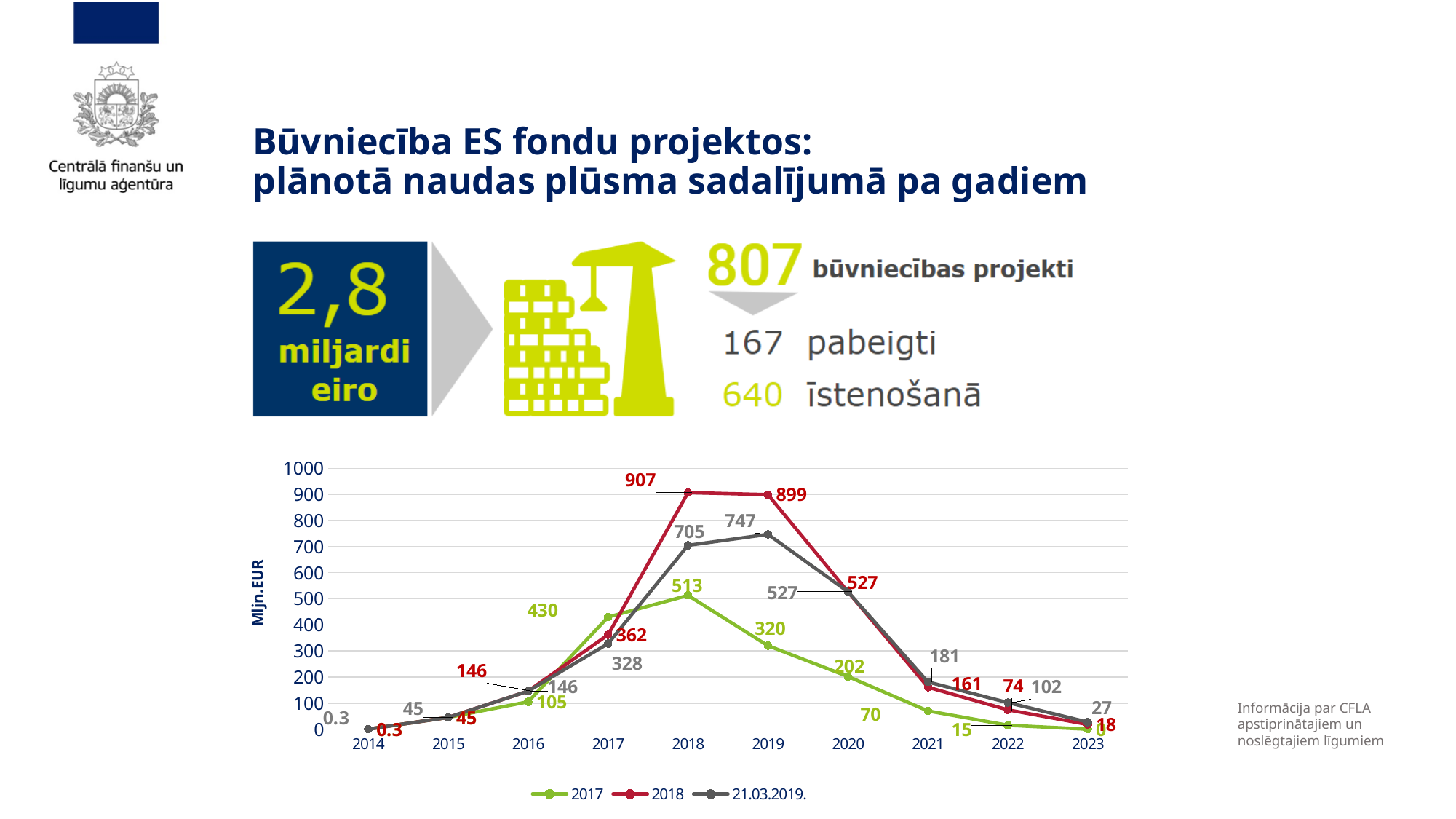
How many series does the chart legend list? 3 What is the value of the 2018 series in 2018? 907 How many years are shown on the x axis of the chart? 10 What is the difference between the 2018 series and the 21.03.2019. series in 2018? 202 In which year does the 21.03.2019. series reach its highest value? 2019 What is the value of the 21.03.2019. series in 2019? 747 What is the value of the 2017 series in 2018? 513 What is the value of the 2017 series in 2020? 202 What is the label of the y axis of the chart? Mljn.EUR In which year does the 2018 series reach its highest value? 2018 Which series has the larger value in 2019, the 2018 series or the 2017 series? 2018 What kind of chart is shown on the slide? line chart